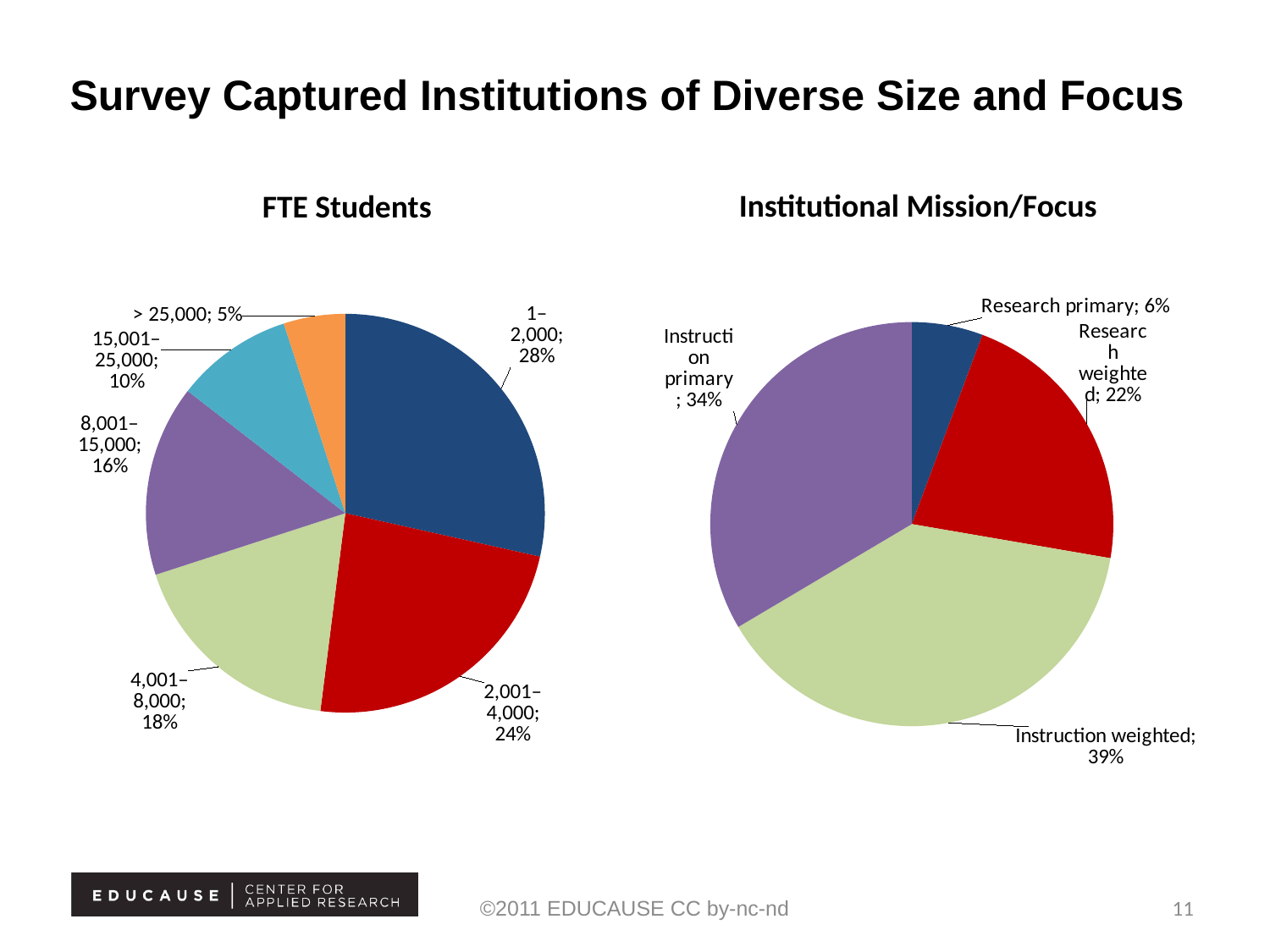
In the FTE Students chart, what share of institutions have 1–2,000 FTE students? 28% In the FTE Students chart, what is the difference in percentage points between the 2,001–4,000 and 15,001–25,000 categories? 14 What type of chart is used for the FTE Students chart? Pie chart In the Institutional Mission/Focus chart, how many categories are shown? 4 In the Institutional Mission/Focus chart, which is larger: Research weighted or Instruction primary? Instruction primary In the FTE Students chart, which FTE category has the largest share? 1–2,000 In the Institutional Mission/Focus chart, what share of institutions are Research primary? 6% In the Institutional Mission/Focus chart, which category has the largest share? Instruction weighted In the Institutional Mission/Focus chart, what share of institutions are Instruction weighted? 39% In the FTE Students chart, which FTE category has the smallest share? > 25,000 In the FTE Students chart, how many FTE categories are shown? 6 In the FTE Students chart, what share of institutions have 4,001–8,000 FTE students? 18%